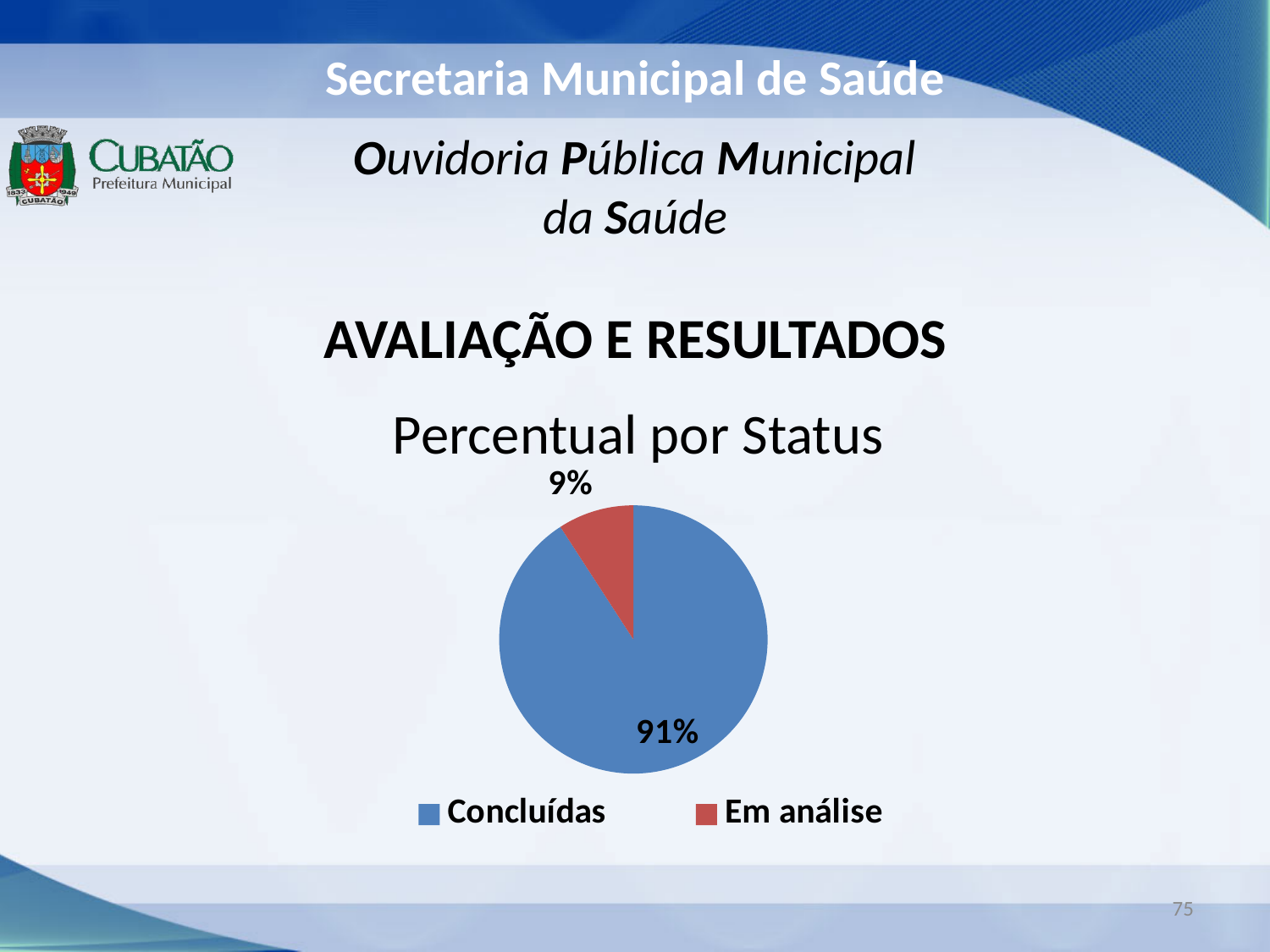
What percentage of the pie is labelled Em análise? 9% What kind of chart is shown on the slide? pie chart What colour is the slice for Em análise? red What percentage of the pie is labelled Concluídas? 91% How many slices does the pie chart have? 2 What is the title of the chart? Percentual por Status What is the difference in percentage points between Concluídas and Em análise? 82 Which is larger, the share for Concluídas or the share for Em análise? Concluídas Which category has the smallest share of the pie? Em análise Which category has the largest share of the pie? Concluídas How many entries does the legend list? 2